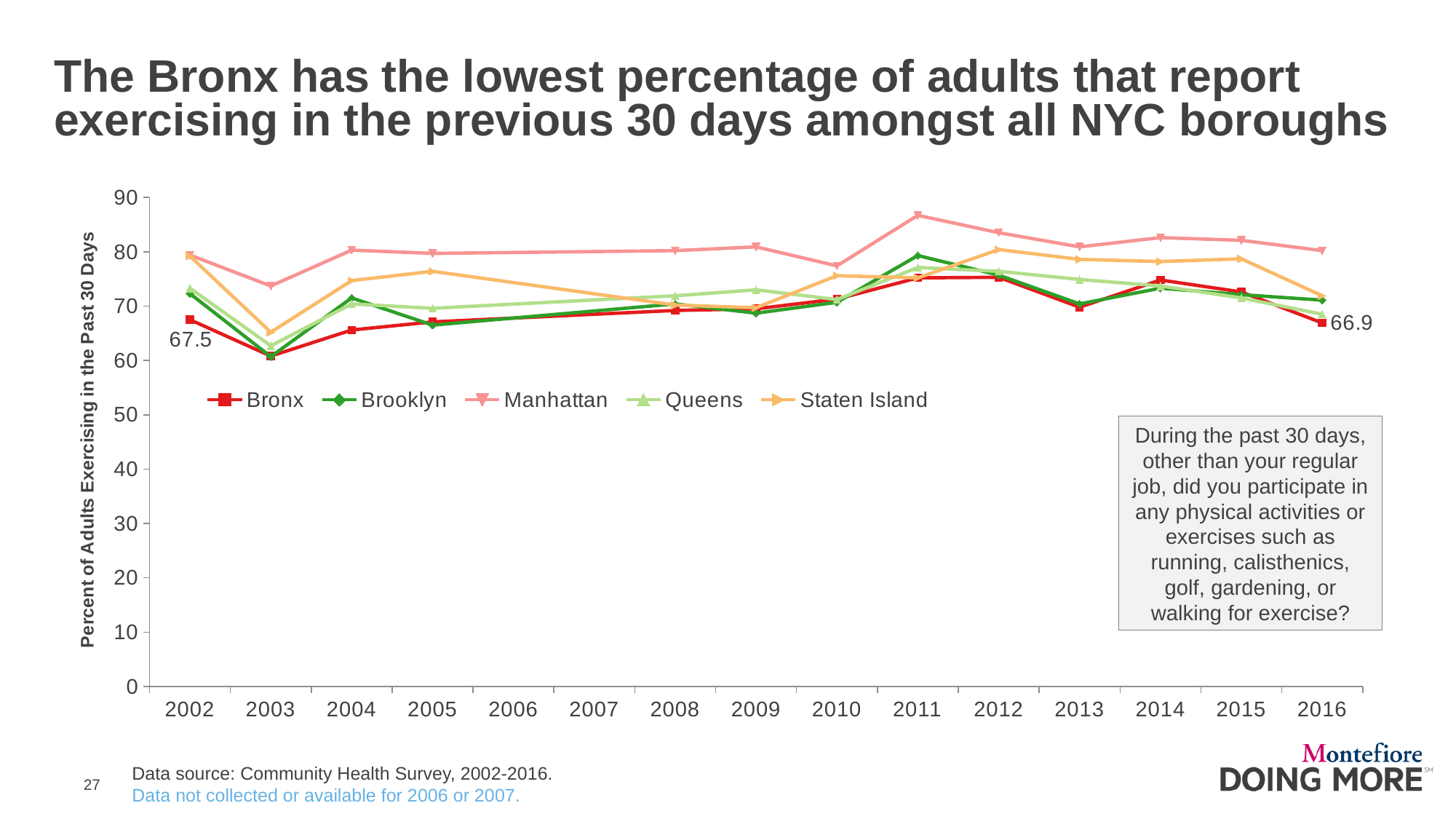
Is the value for the Bronx in 2003 greater or less than 70? less What is the Bronx value in 2002? 67.5 Which borough has the lowest value in 2002? Bronx Which borough has the highest value in 2011? Manhattan Is the value for Manhattan in 2011 greater or less than 80? greater For which years was data not collected or available? 2006 and 2007 What is the Bronx value in 2016? 66.9 How many years are labeled on the x axis? 15 By how much did the Bronx value change from 2002 to 2016? 0.6 How many series does the legend list? 5 What kind of chart is shown on the slide? Line chart Which is larger in 2016, the value for Manhattan or the value for the Bronx? Manhattan